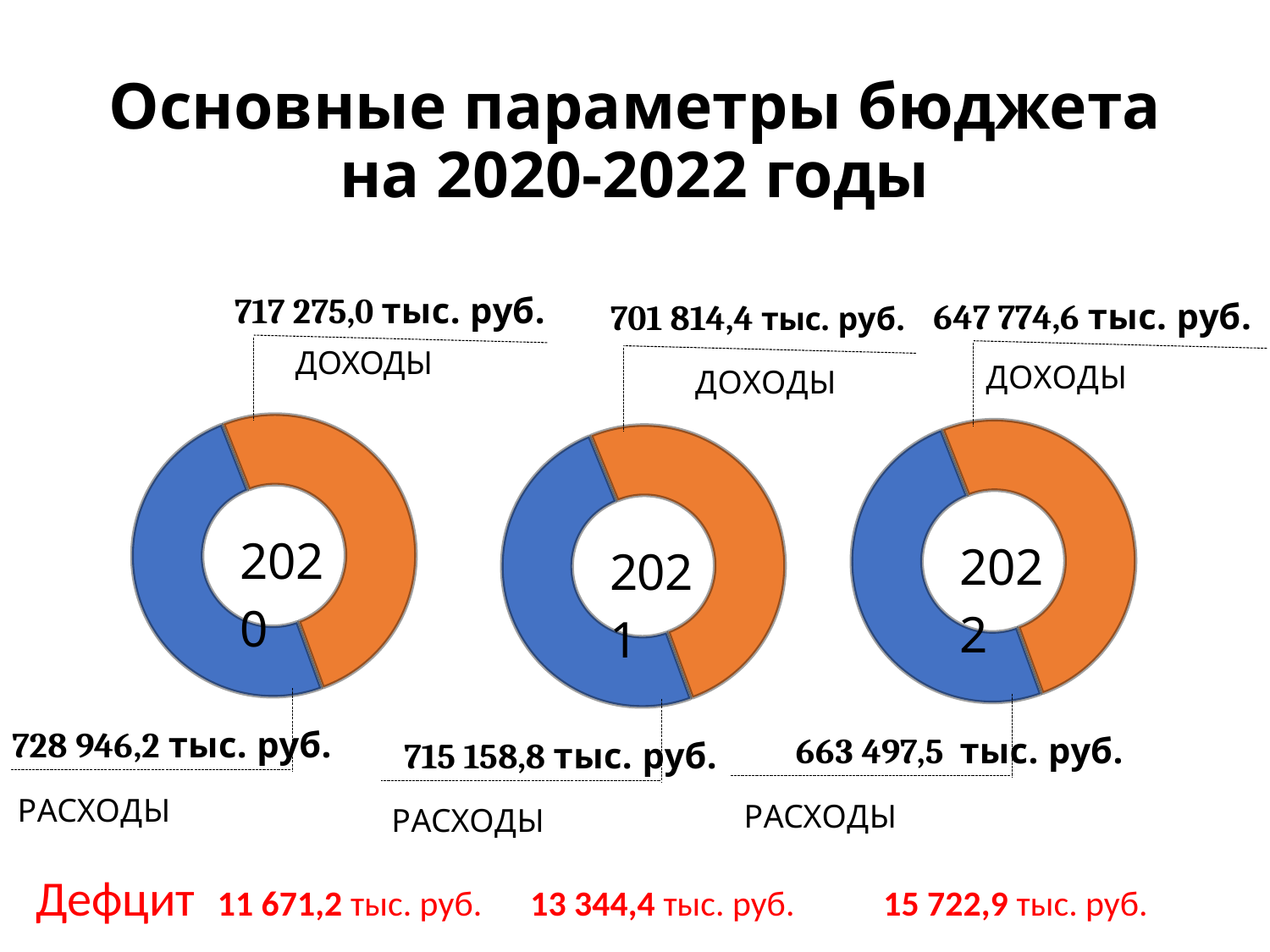
In the 2021 donut chart, what is the value for РАСХОДЫ? 715 158,8 тыс. руб. In the 2021 donut chart, what is the value for ДОХОДЫ? 701 814,4 тыс. руб. What kind of chart is used for each year on the slide? Donut (pie) chart In the 2022 donut chart, what is the value for РАСХОДЫ? 663 497,5 тыс. руб. In the 2022 donut chart, which is larger, ДОХОДЫ or РАСХОДЫ? РАСХОДЫ In the 2020 donut chart, what is the difference between РАСХОДЫ and ДОХОДЫ? 11 671,2 тыс. руб. In the 2022 donut chart, what is the value for ДОХОДЫ? 647 774,6 тыс. руб. Across the three charts from 2020 to 2022, do the ДОХОДЫ values rise or fall? Fall In the 2021 donut chart, what is the difference between РАСХОДЫ and ДОХОДЫ? 13 344,4 тыс. руб. In the 2020 donut chart, what is the value for ДОХОДЫ? 717 275,0 тыс. руб. In the 2020 donut chart, what is the value for РАСХОДЫ? 728 946,2 тыс. руб. How many categories does each donut chart show? 2